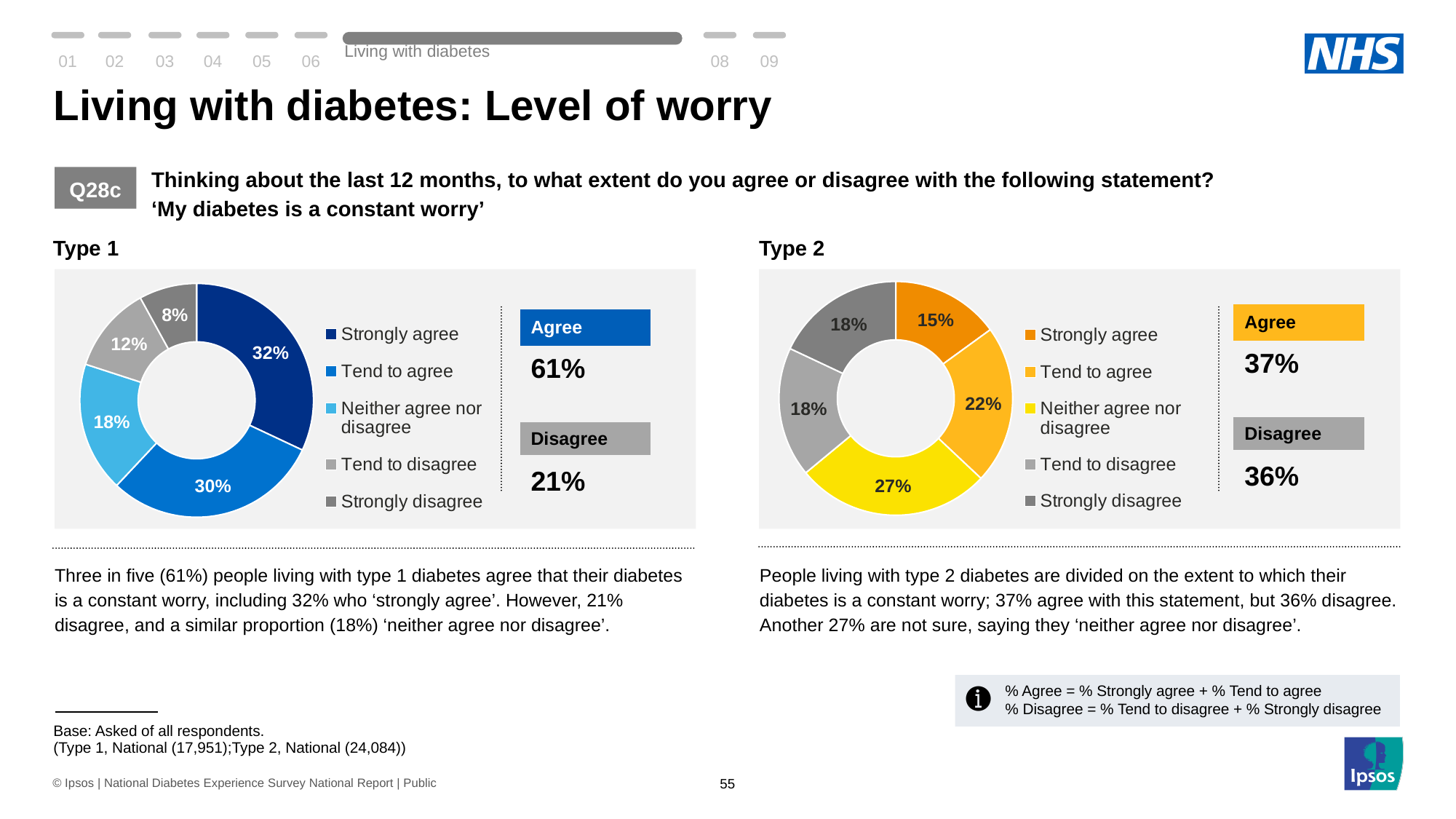
Which is larger: 'tend to agree' in the Type 1 chart or 'tend to agree' in the Type 2 chart? Type 1 (30%) What is the difference in percentage points between 'strongly agree' in the Type 1 chart and 'strongly agree' in the Type 2 chart? 17 percentage points In the Type 2 chart, which response category has the smallest share? Strongly agree In the Type 1 chart, what percentage of respondents 'strongly agree'? 32% How many response categories does the legend of the Type 1 chart list? 5 In the Type 1 chart, what percentage of respondents 'tend to disagree'? 12% What type of chart is used for the Type 2 data? Donut (pie) chart In the Type 1 chart, which response category has the smallest share? Strongly disagree In the Type 2 chart, which response category has the largest share? Neither agree nor disagree In the Type 2 chart, what percentage of respondents 'neither agree nor disagree'? 27% In the Type 1 chart, which response category has the largest share? Strongly agree In the Type 2 chart, what percentage of respondents 'tend to agree'? 22%